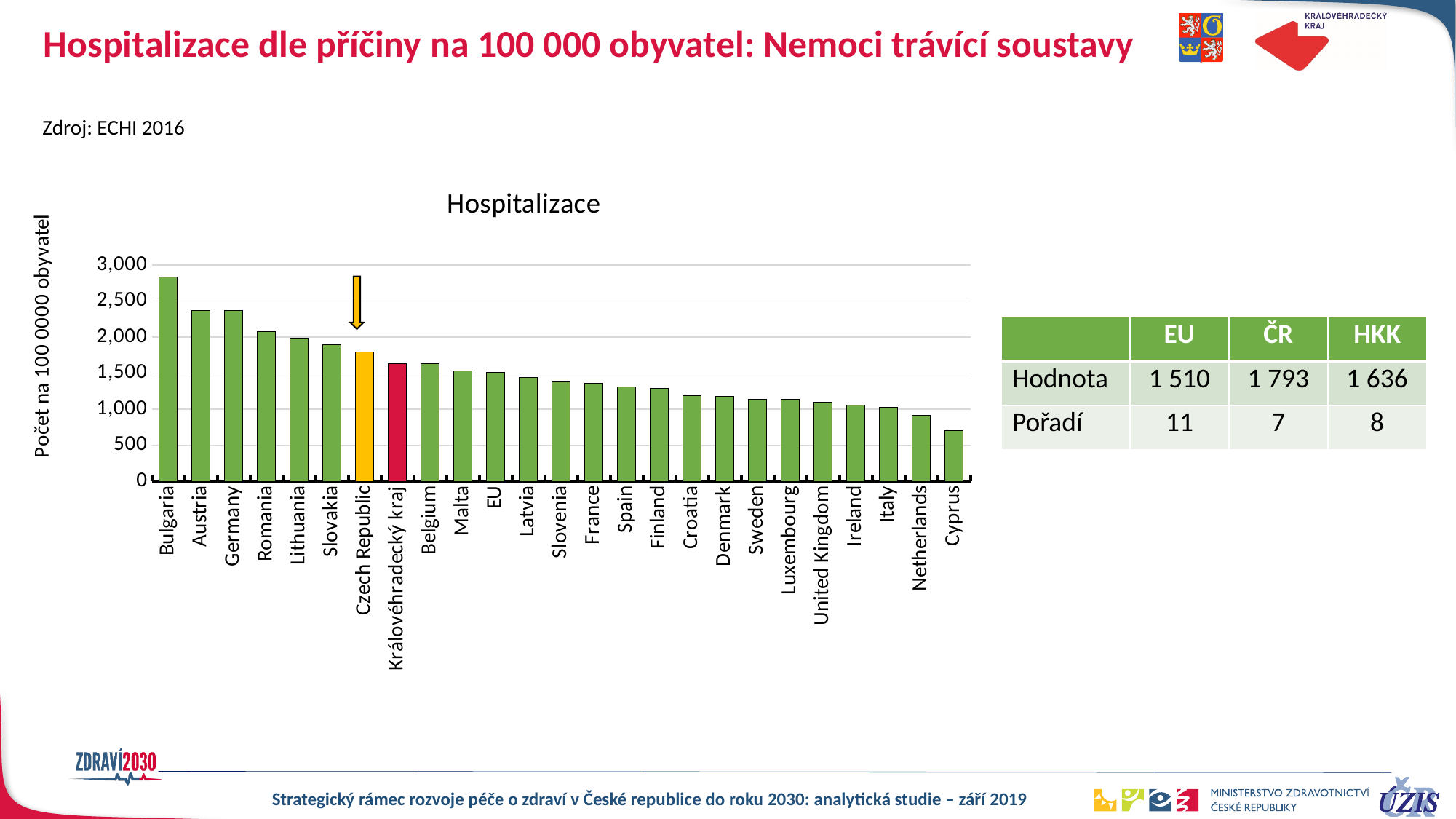
What is the difference between the ČR value and the EU value given in the table? 283 Is the value for Slovakia greater or less than 2,000? less How many bars (categories) are plotted in the chart? 25 What kind of chart is shown on the slide? bar chart Is the value for Cyprus greater or less than 1,000? less According to the table, what is the hospitalization value (Hodnota) for ČR? 1 793 Which bar is larger, Czech Republic or Královéhradecký kraj? Czech Republic Is the value for Bulgaria greater or less than 2,500? greater Which country has the lowest hospitalization rate in the chart? Cyprus Do the values rise or fall from left to right along the x axis? fall Which country has the highest hospitalization rate in the chart? Bulgaria